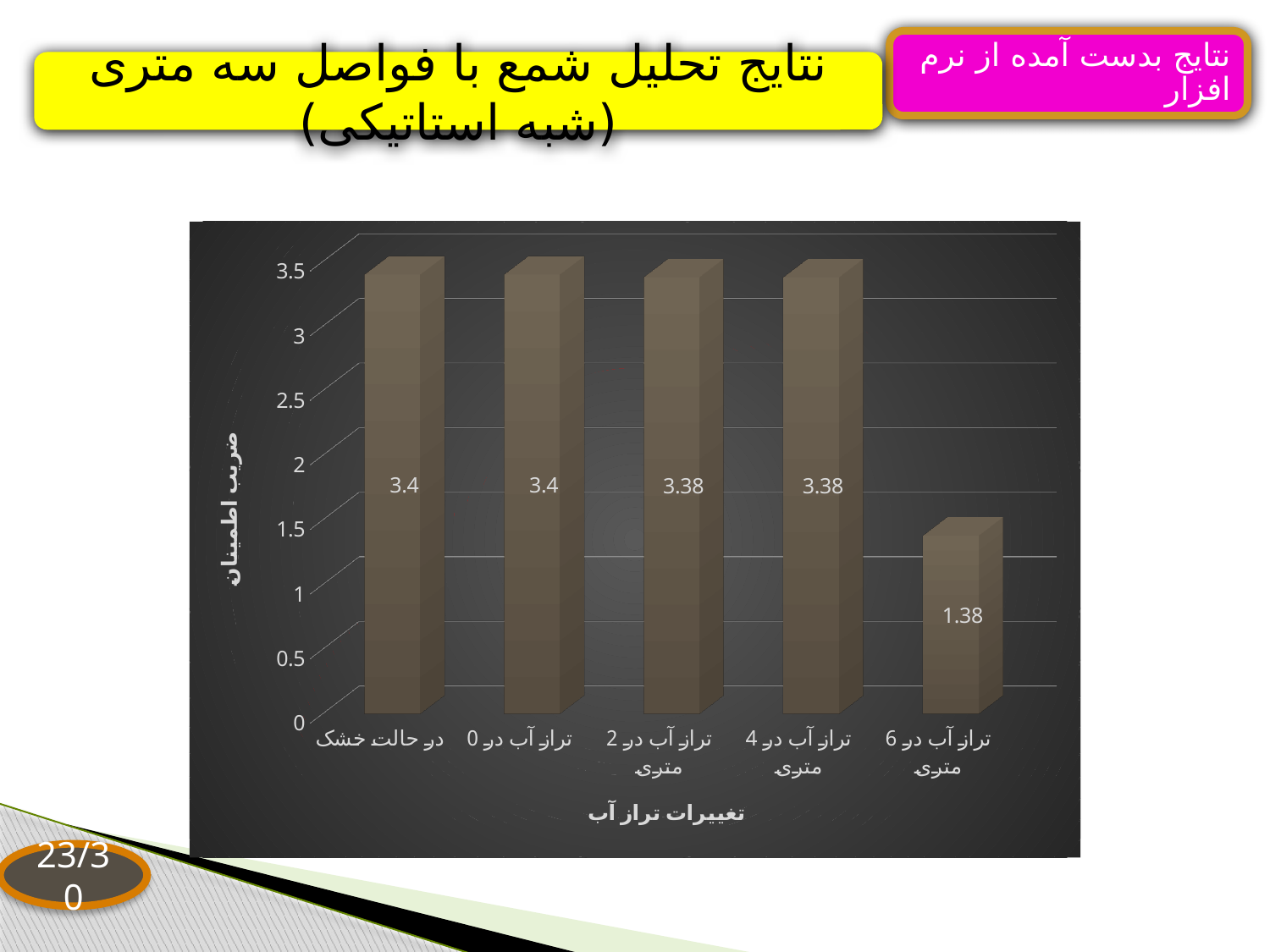
What is the value for the category "تراز آب در 6 متری"? 1.38 What is the label of the vertical axis? ضریب اطمینان What is the value for the category "در حالت خشک"? 3.4 What is the value for the category "تراز آب در 2 متری"? 3.38 What is the value for the category "تراز آب در 0"? 3.4 What kind of chart is shown on the slide? bar chart What is the difference between the values for "تراز آب در 4 متری" and "تراز آب در 6 متری"? 2 Which category has the lowest value? تراز آب در 6 متری Is the value for "تراز آب در 6 متری" greater or less than 2? less How many categories are shown on the x axis? 5 Which is larger, the value for "تراز آب در 0" or the value for "تراز آب در 6 متری"? تراز آب در 0 What is the difference between the values for "در حالت خشک" and "تراز آب در 2 متری"? 0.02